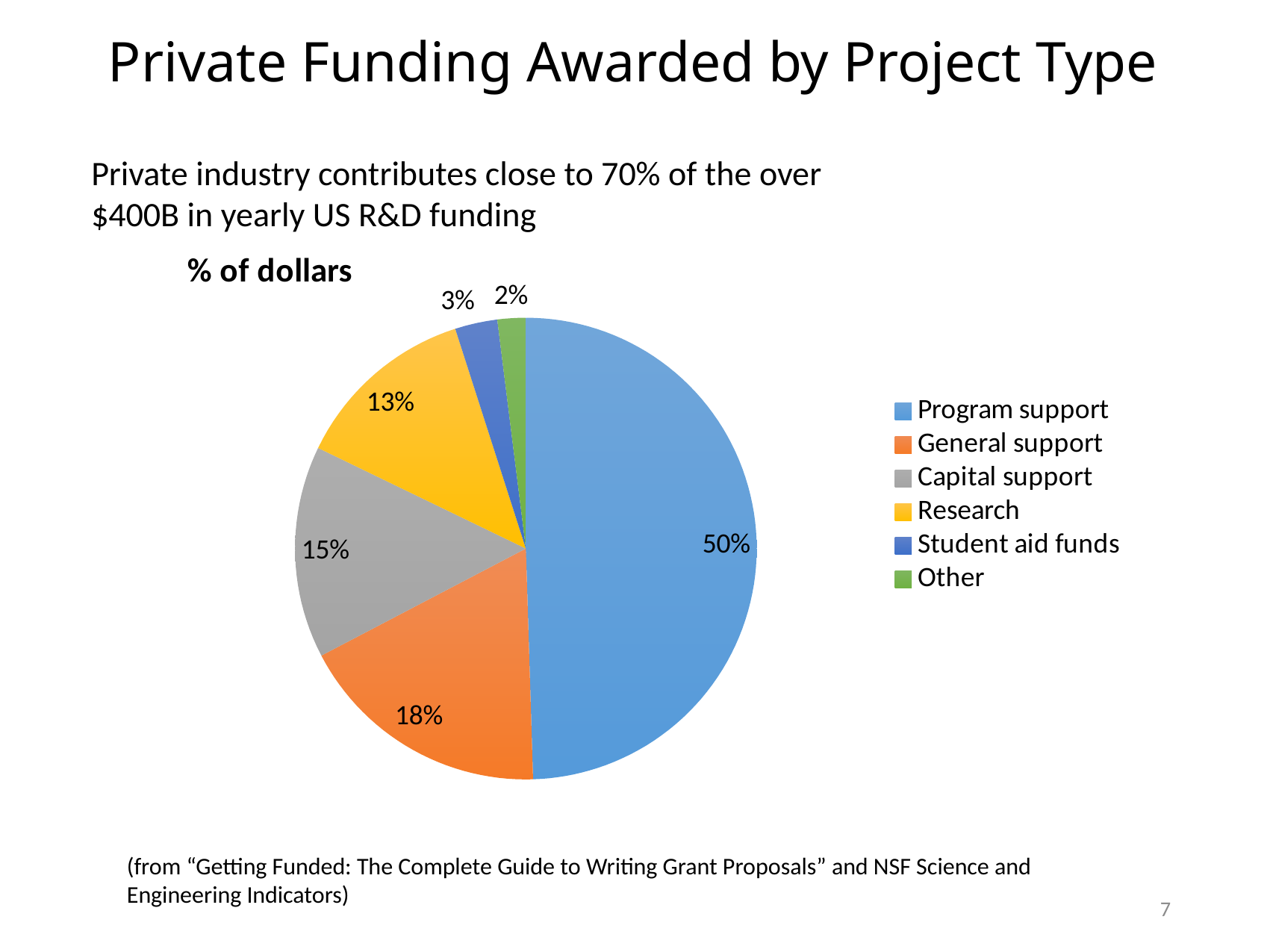
Which project type receives the smallest share of dollars? Other What is the title of the chart? % of dollars How many project types does the legend list? 6 Which receives a larger share of dollars, Capital support or Research? Capital support What share of dollars goes to Student aid funds? 3% What is the difference in percentage points between General support and Research? 5 Which project type receives the largest share of dollars? Program support What share of dollars goes to General support? 18% What kind of chart is shown on the slide? pie chart What share of dollars goes to Capital support? 15%